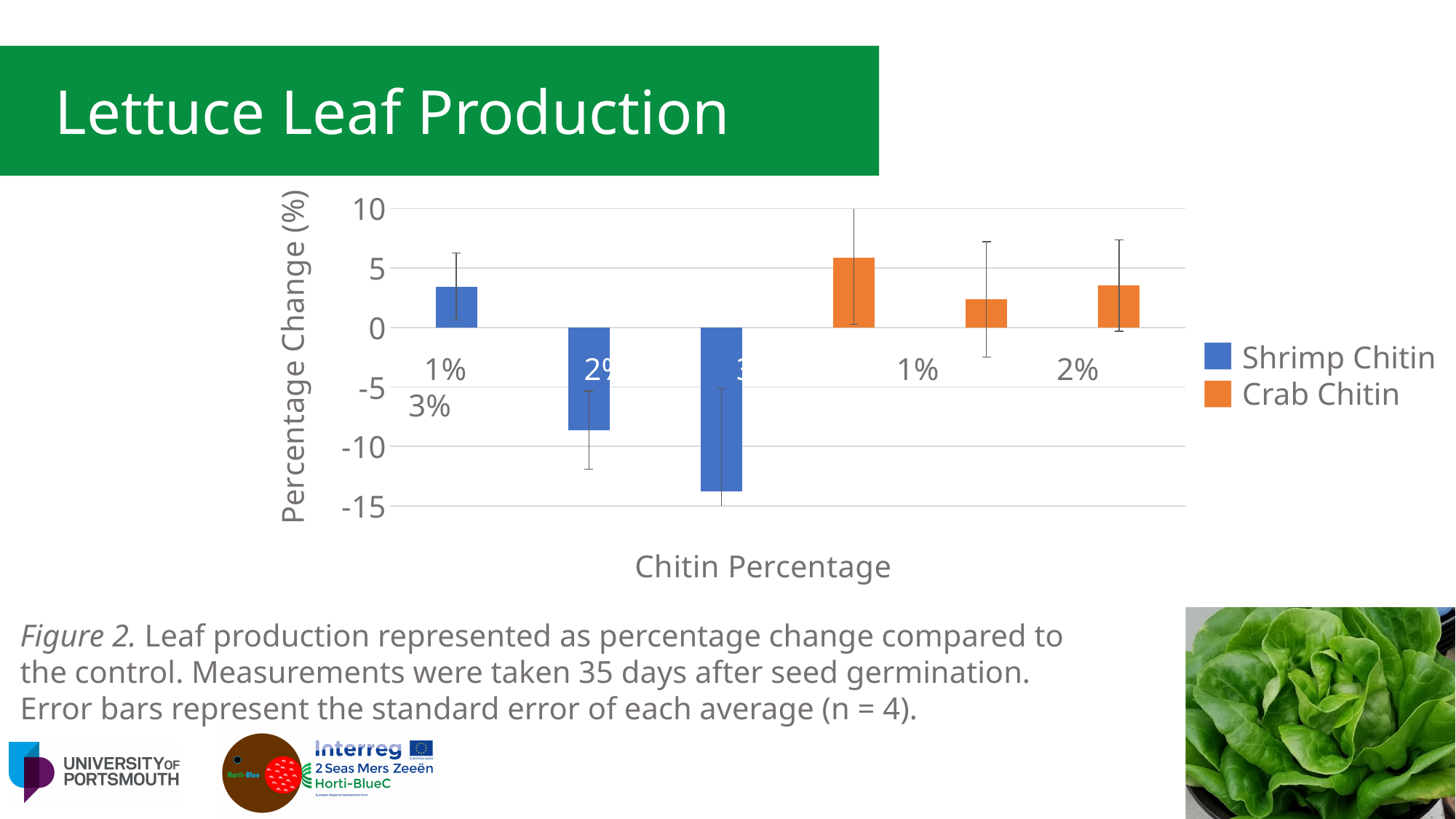
Which bar shows the lowest percentage change? Shrimp Chitin 3% What are the two series named in the legend? Shrimp Chitin and Crab Chitin How many series does the legend list? 2 Which bar shows the highest percentage change? Crab Chitin 1% Which is larger, the value for Shrimp Chitin at 1% or Crab Chitin at 1%? Crab Chitin at 1% Is the value for Crab Chitin at 1% greater or less than 5? greater Is the value for Shrimp Chitin at 2% greater or less than -5? less Do the Shrimp Chitin values rise or fall as the chitin percentage increases from 1% to 3%? fall What type of chart is shown on the slide? bar chart What is the label of the vertical axis? Percentage Change (%) How many bars are plotted in the chart? 6 Is the value for Shrimp Chitin at 3% greater or less than -10? less